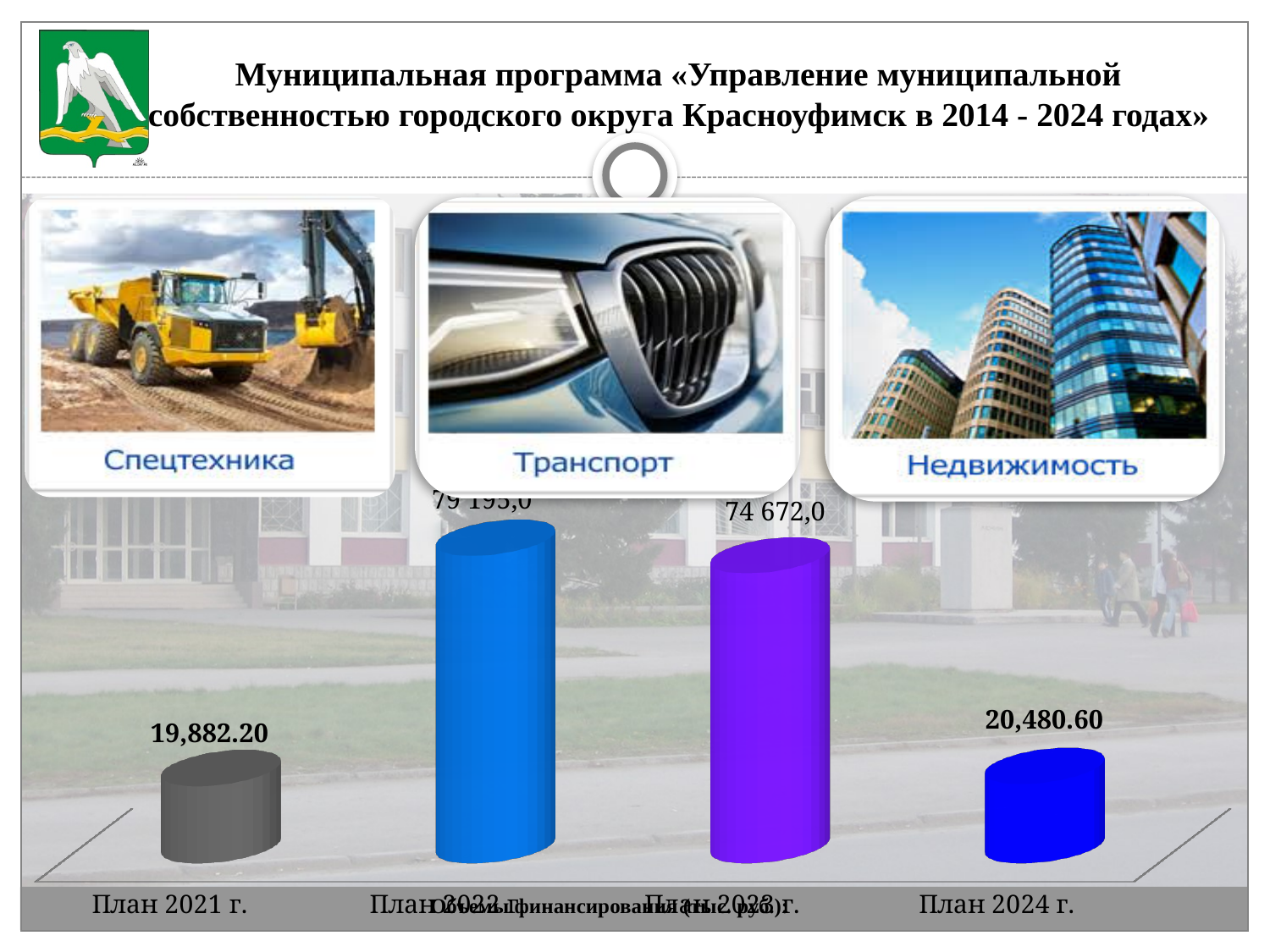
Which is larger, the value for План 2021 г. or План 2024 г.? План 2024 г. What kind of chart is shown on the slide? Bar chart What is the value for План 2024 г.? 20,480.60 What is the value for План 2023 г.? 74 672,0 Do the values rise or fall from План 2023 г. to План 2024 г.? Fall Which category has the lowest value? План 2021 г. Which category has the highest value? План 2022 г. Which is larger, the value for План 2023 г. or План 2024 г.? План 2023 г. How many categories are shown in the chart? 4 What is the value for План 2021 г.? 19,882.20 What colour is the bar for План 2021 г.? Grey What is the difference between the values for План 2024 г. and План 2021 г.? 598.40